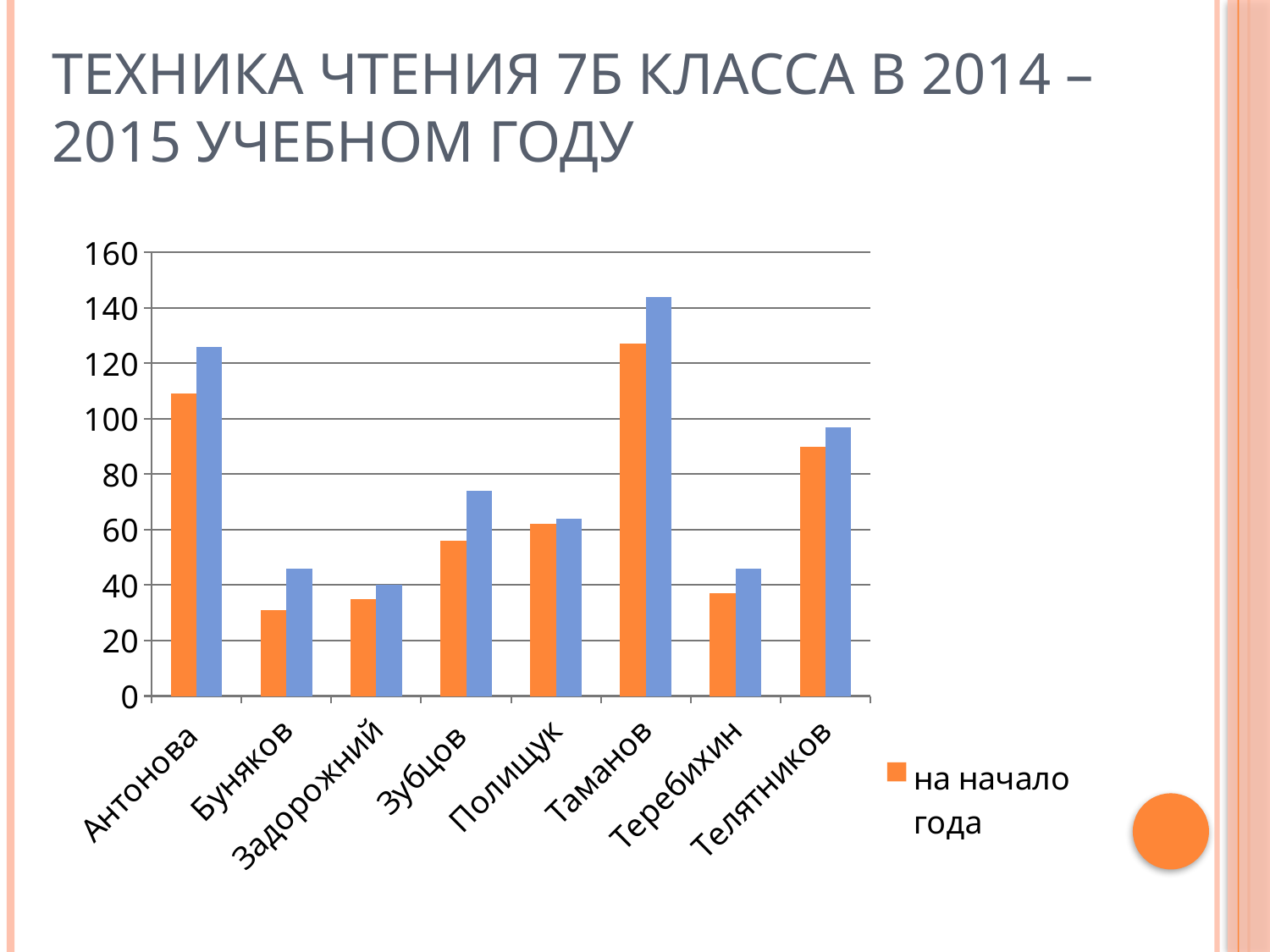
Is the blue bar for Таманов greater or less than 140? greater Is the blue bar for Телятников greater or less than 100? less What kind of chart is shown on the slide? bar chart Which student has the lowest blue bar? Задорожний Which is larger: the 'на начало года' value for Антонова or for Таманов? Таманов Which student has the highest blue bar? Таманов Is the 'на начало года' value for Зубцов greater or less than 60? less What series name is shown in the legend next to the orange square? на начало года Which student has the highest value for the orange series 'на начало года'? Таманов How many students (categories) are shown on the x axis? 8